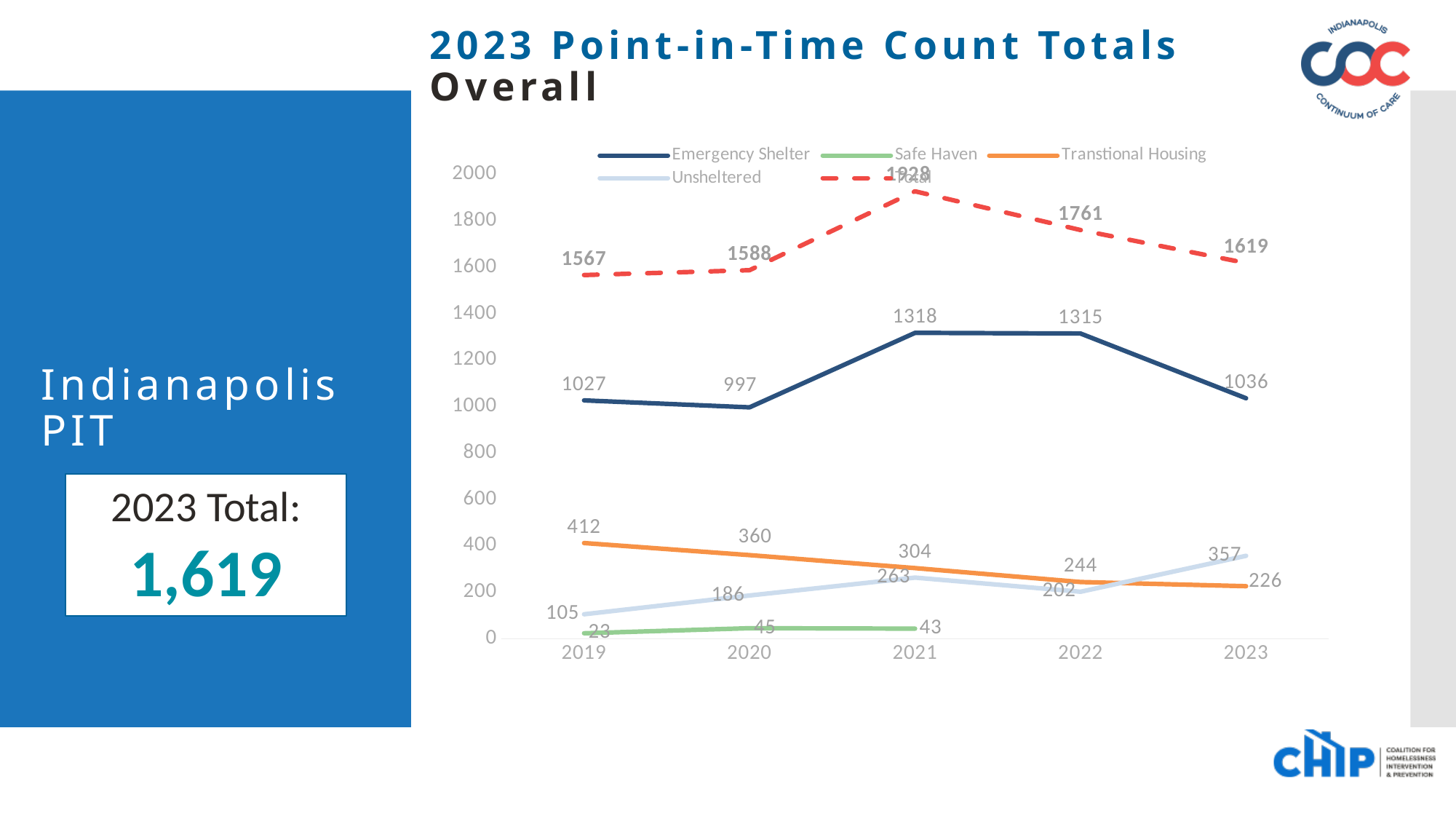
In which year was the Total count highest? 2021 Which was larger in 2023, the Unsheltered count or the Transitional Housing count? Unsheltered In which year was the Unsheltered count lowest? 2019 What type of chart is shown on the slide? Line chart What was the Unsheltered count in 2023? 357 What was the Emergency Shelter count in 2021? 1318 What was the Transitional Housing count in 2019? 412 What is the difference between the Total count in 2021 and the Total count in 2023? 309 Does the Transitional Housing count rise or fall from 2019 to 2023? Fall What was the Safe Haven count in 2020? 45 How many years are shown on the x axis? 5 How many series does the legend list? 5